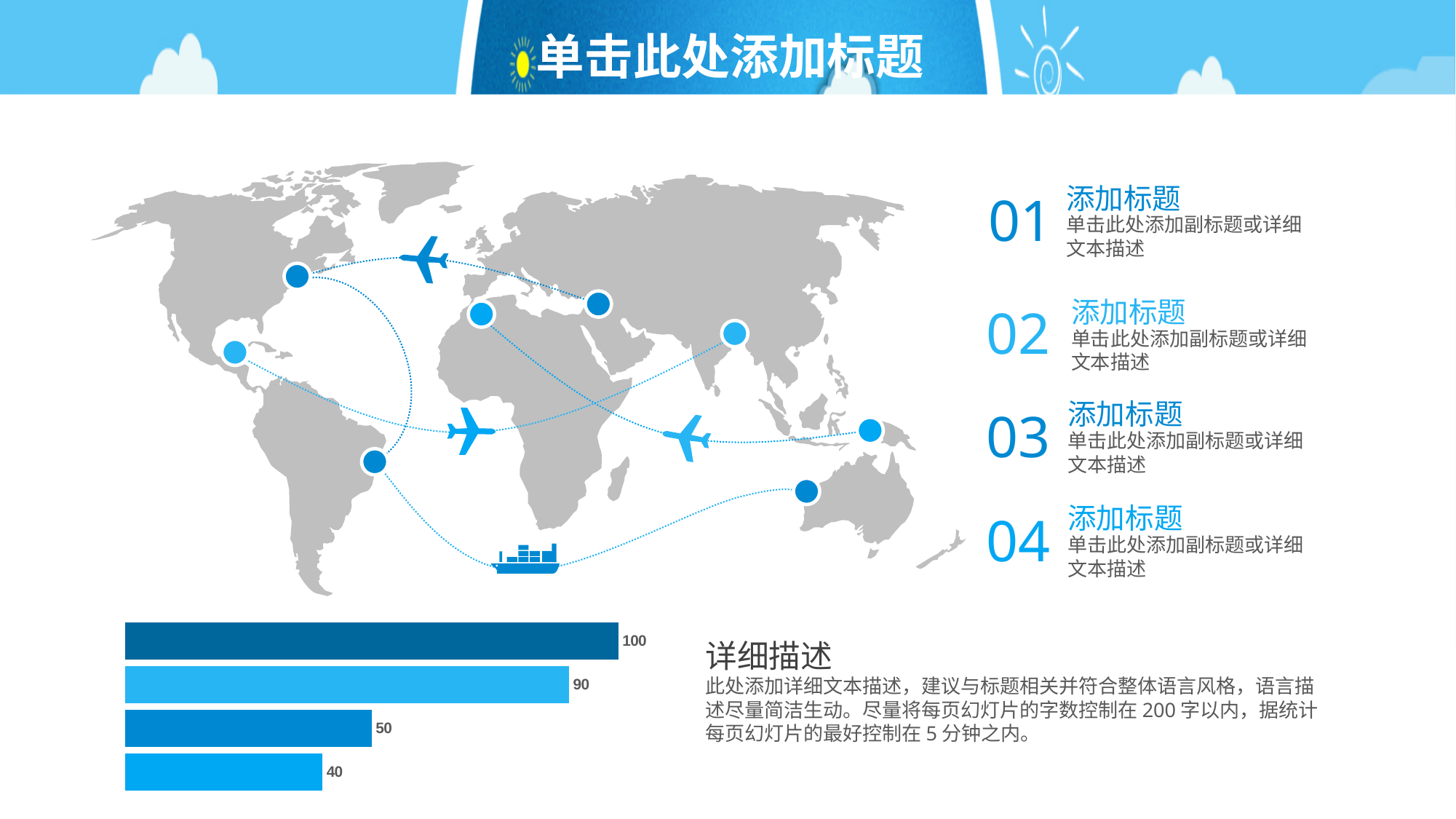
In the bar chart at the bottom left, what is the value of the third bar from the top? 50 In the bar chart at the bottom left, what is the value of the bottom bar? 40 In the bar chart at the bottom left, what is the value of the second bar from the top? 90 What kind of chart is shown at the bottom left of the slide? bar chart In the bar chart at the bottom left, what is the value of the top bar? 100 How many bars does the bar chart at the bottom left of the slide have? 4 In the bar chart at the bottom left, which bar has the lowest value? the bottom bar (40) In the bar chart at the bottom left, which is larger: the second bar from the top or the third bar from the top? the second bar (90) In the bar chart at the bottom left, what is the difference between the second bar and the third bar? 40 In the bar chart at the bottom left, do the bar values increase or decrease going from the top bar to the bottom bar? decrease In the bar chart at the bottom left, which bar has the highest value? the top bar (100) In the bar chart at the bottom left, what is the difference between the top bar and the bottom bar? 60